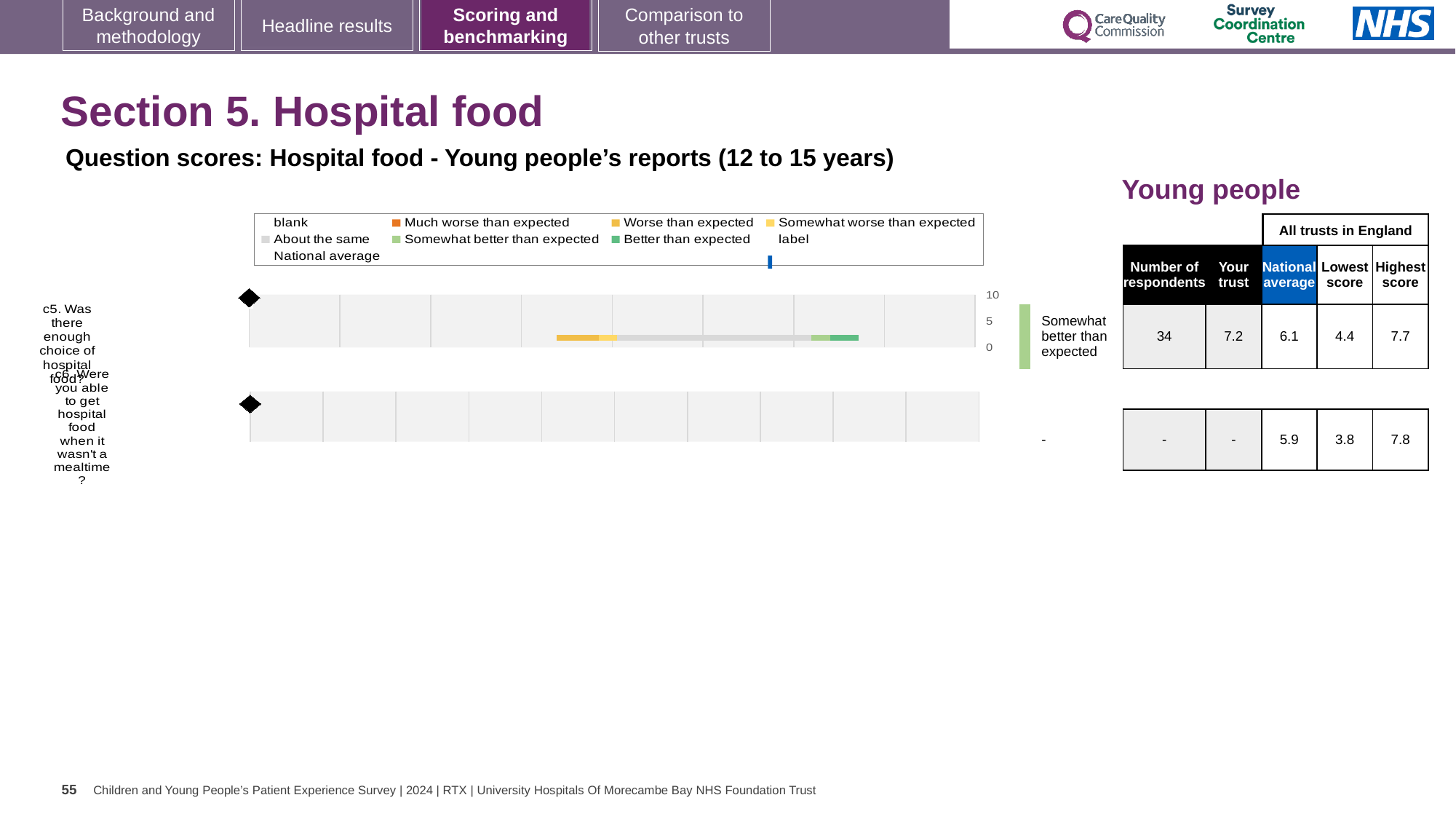
Is the trust's score for question c5 greater or less than 5 on the chart axis? greater For question c5, what is the difference between the highest and lowest scores among all trusts in England? 3.3 What is the highest score among all trusts in England for question c5? 7.7 How many questions are plotted on the hospital food chart? 2 What is the national average score for question c5 (Was there enough choice of hospital food?)? 6.1 What kind of chart is used to show the question scores for hospital food? Bar chart What benchmark category is shown for question c5 (Was there enough choice of hospital food?)? Somewhat better than expected For question c5, what is the difference between the trust's score and the national average? 1.1 What is the lowest score among all trusts in England for question c6 (Were you able to get hospital food when it wasn't a mealtime?)? 3.8 How many respondents answered question c5 (Was there enough choice of hospital food?)? 34 For question c5, which is larger: the trust's score or the national average? Your trust What is the 'Your trust' score for question c5 (Was there enough choice of hospital food?)? 7.2